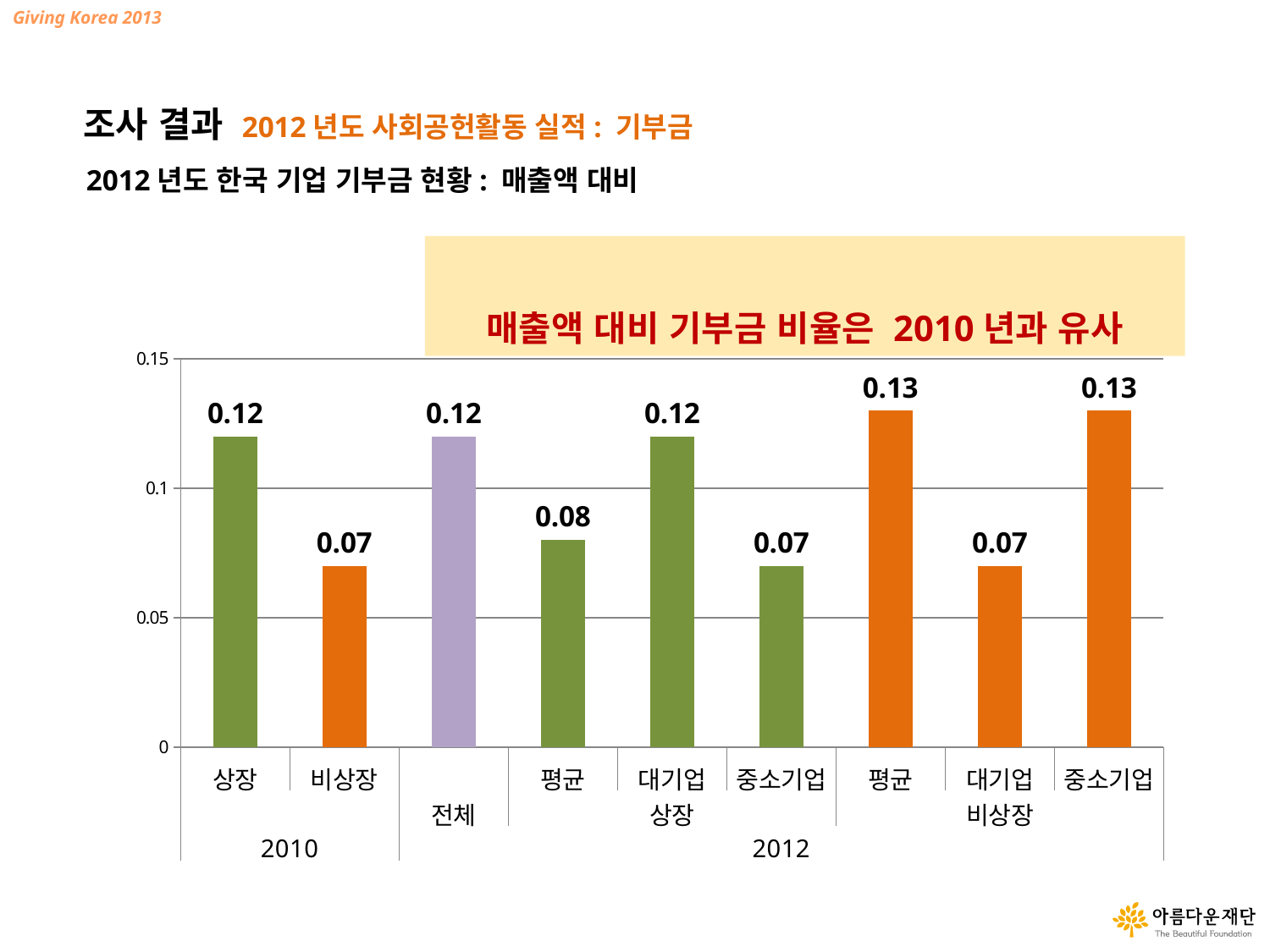
How many bars are plotted on the chart? 9 What is the value for 전체? 0.12 What is the value for 상장 in the 2010 group? 0.12 What is the highest value shown on the chart? 0.13 What is the value for 비상장 in the 2010 group? 0.07 What type of chart is shown on the slide? bar chart What is the value for 중소기업 in the 2012 비상장 group? 0.13 Which is larger: 평균 in the 2012 상장 group or 평균 in the 2012 비상장 group? 평균 in the 2012 비상장 group What is the highest tick value shown on the vertical axis? 0.15 What is the difference between 대기업 and 중소기업 in the 2012 상장 group? 0.05 What is the lowest value shown on the chart? 0.07 What is the value for 평균 in the 2012 상장 group? 0.08